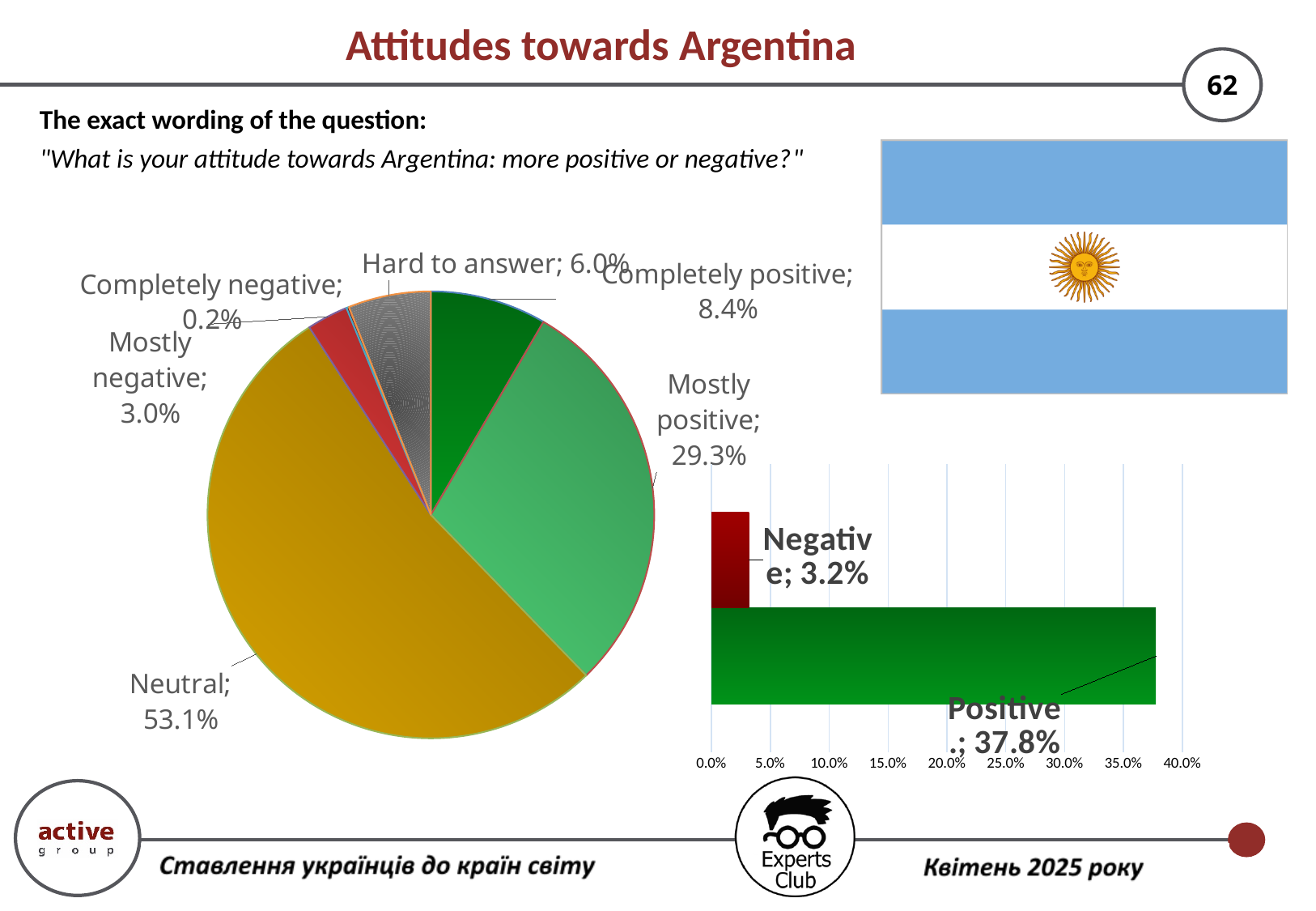
How many categories does the pie chart show? 6 In the pie chart, which category has the largest share? Neutral In the pie chart, what is the value for "Completely negative"? 0.2% In the bar chart on the right, what is the value for "Negative"? 3.2% In the pie chart, what is the difference between "Mostly positive" and "Completely positive"? 20.9% In the pie chart, what is the value for "Hard to answer"? 6.0% In the pie chart, which category has the smallest share? Completely negative In the bar chart on the right, what is the value for "Positive"? 37.8% In the pie chart, what share of respondents answered "Neutral"? 53.1% In the pie chart, which is larger: "Mostly negative" or "Hard to answer"? Hard to answer In the bar chart on the right, what is the difference between "Positive" and "Negative"? 34.6% In the pie chart, what is the value for "Mostly positive"? 29.3%